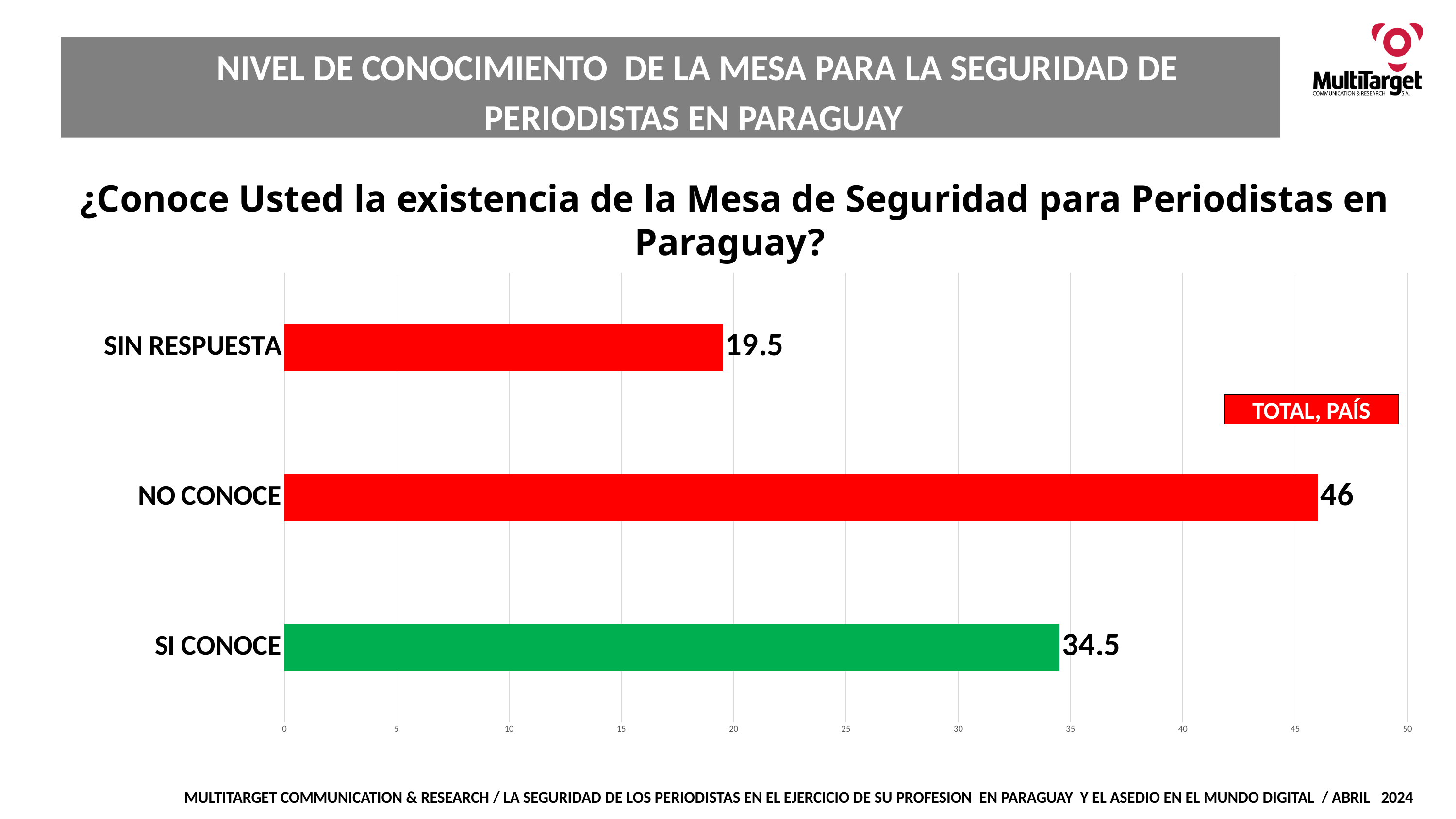
What colour is the bar for SI CONOCE? green Which category has the lowest value? SIN RESPUESTA What is the value for SI CONOCE? 34.5 Is the value for NO CONOCE greater or less than 40? greater What kind of chart is shown on the slide? bar chart What is the difference between the values for NO CONOCE and SI CONOCE? 11.5 How many categories are shown in the chart? 3 What is the value for NO CONOCE? 46 What is the value for SIN RESPUESTA? 19.5 Which is larger, the value for SI CONOCE or the value for SIN RESPUESTA? SI CONOCE What is the difference between the values for SI CONOCE and SIN RESPUESTA? 15 Which category has the highest value? NO CONOCE